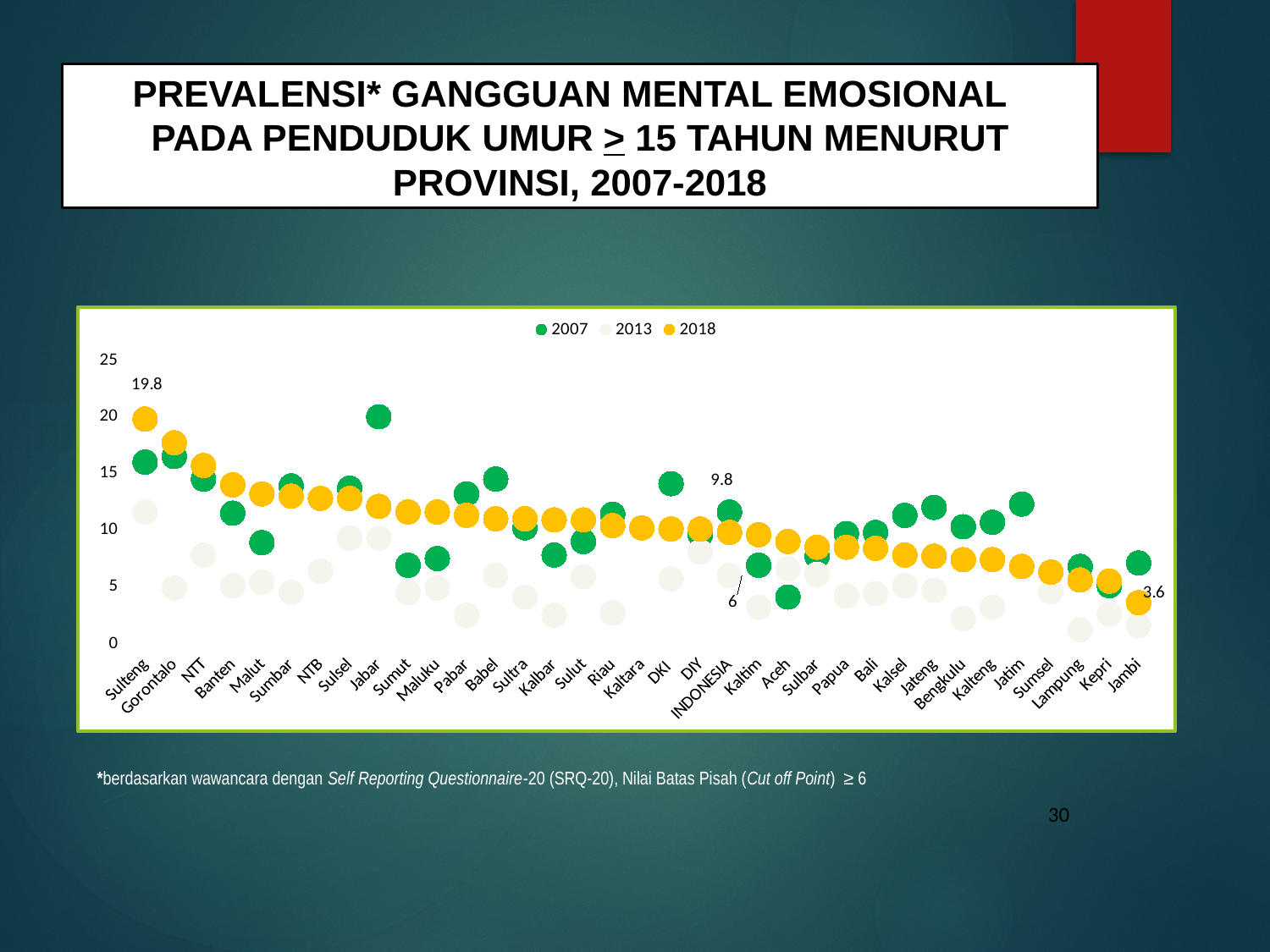
What is the 2013 value for INDONESIA? 6 Which province has the highest 2018 value? Sulteng By how much did the INDONESIA value change from 2013 to 2018? 3.8 How many provinces/categories are shown on the x axis? 35 Do the 2018 values rise or fall moving from left to right along the x axis? fall How many series does the legend list? 3 What is the 2018 value for Jambi? 3.6 What is the 2018 value for Sulteng? 19.8 Is the 2007 value for Jabar greater or less than 15? greater Which province has the lowest 2018 value? Jambi What is the difference between the 2018 values for Sulteng and Jambi? 16.2 What is the 2018 value for INDONESIA? 9.8